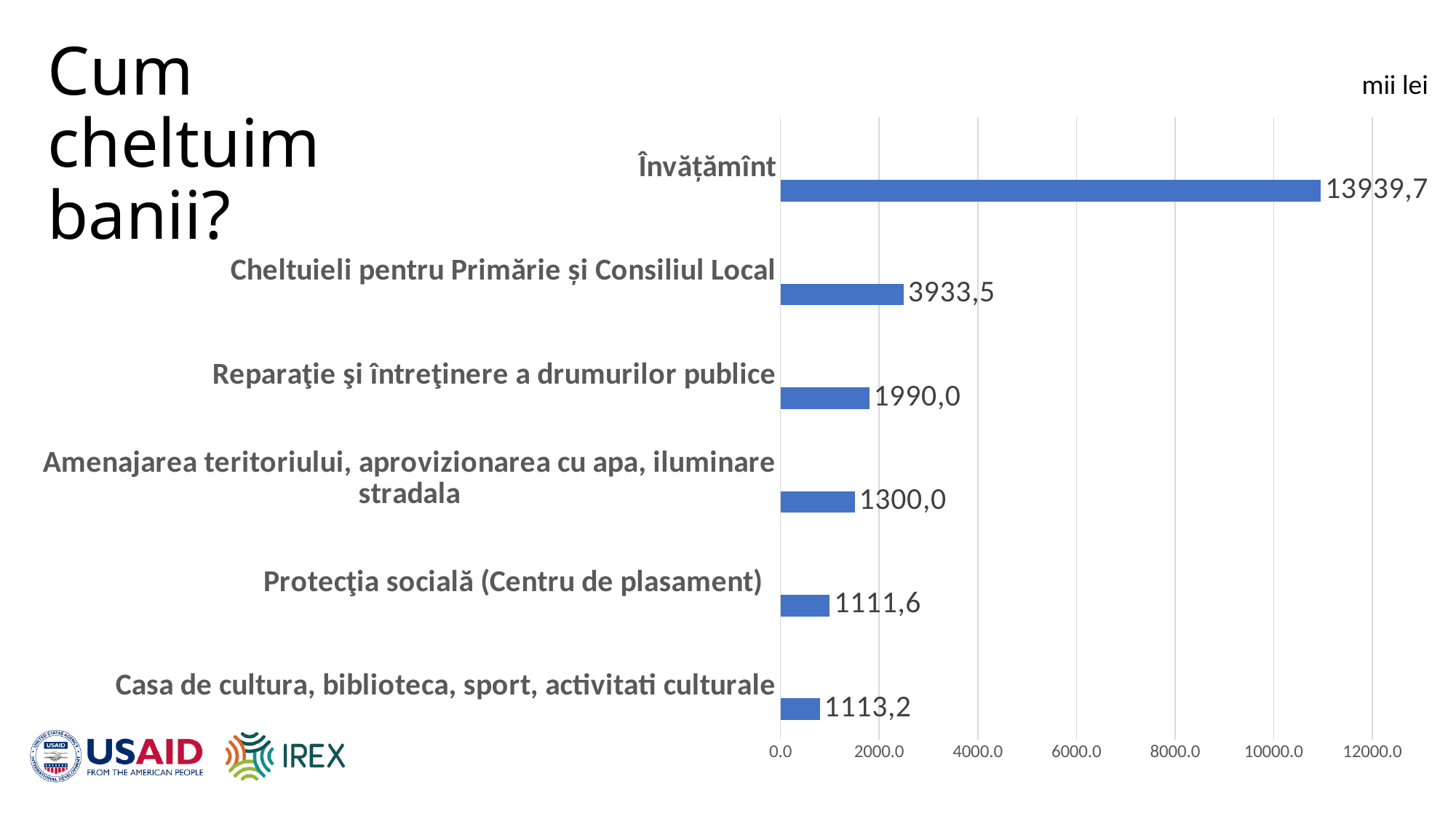
How many categories are shown in the chart? 6 What is the value for Cheltuieli pentru Primărie și Consiliul Local? 3933,5 What unit is indicated for the values in the chart? mii lei What is the difference between the values for Reparaţie şi întreţinere a drumurilor publice and Amenajarea teritoriului, aprovizionarea cu apa, iluminare stradala? 690,0 What is the value for Protecţia socială (Centru de plasament)? 1111,6 What is the value for Învățămînt? 13939,7 What is the difference between the values for Cheltuieli pentru Primărie și Consiliul Local and Reparaţie şi întreţinere a drumurilor publice? 1943,5 What is the value for Reparaţie şi întreţinere a drumurilor publice? 1990,0 What kind of chart is shown on the slide? Bar chart Which category has the highest value? Învățămînt Which is larger: the value for Cheltuieli pentru Primărie și Consiliul Local or the value for Amenajarea teritoriului, aprovizionarea cu apa, iluminare stradala? Cheltuieli pentru Primărie și Consiliul Local